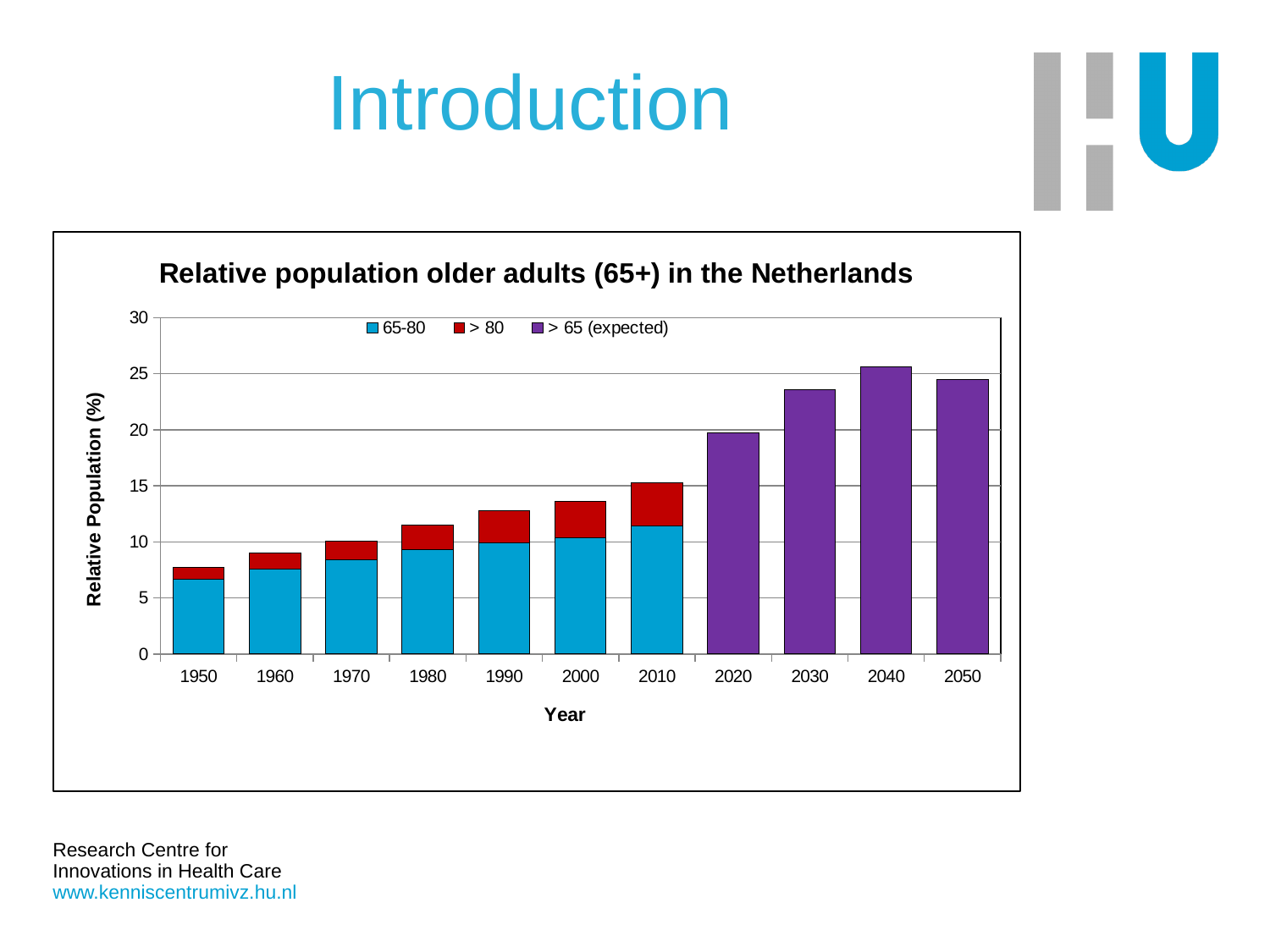
What is the label of the y axis? Relative Population (%) Which year has the highest total relative population of older adults? 2040 Is the value for 2040 greater or less than 25? greater How many series does the legend list? 3 What is the title of the chart? Relative population older adults (65+) in the Netherlands Which year has the lowest total relative population of older adults? 1950 Is the value for 2050 greater or less than 25? less How many years are shown on the x axis? 11 Do the values generally rise or fall from 1950 to 2040? rise What type of chart is shown on the slide? bar chart